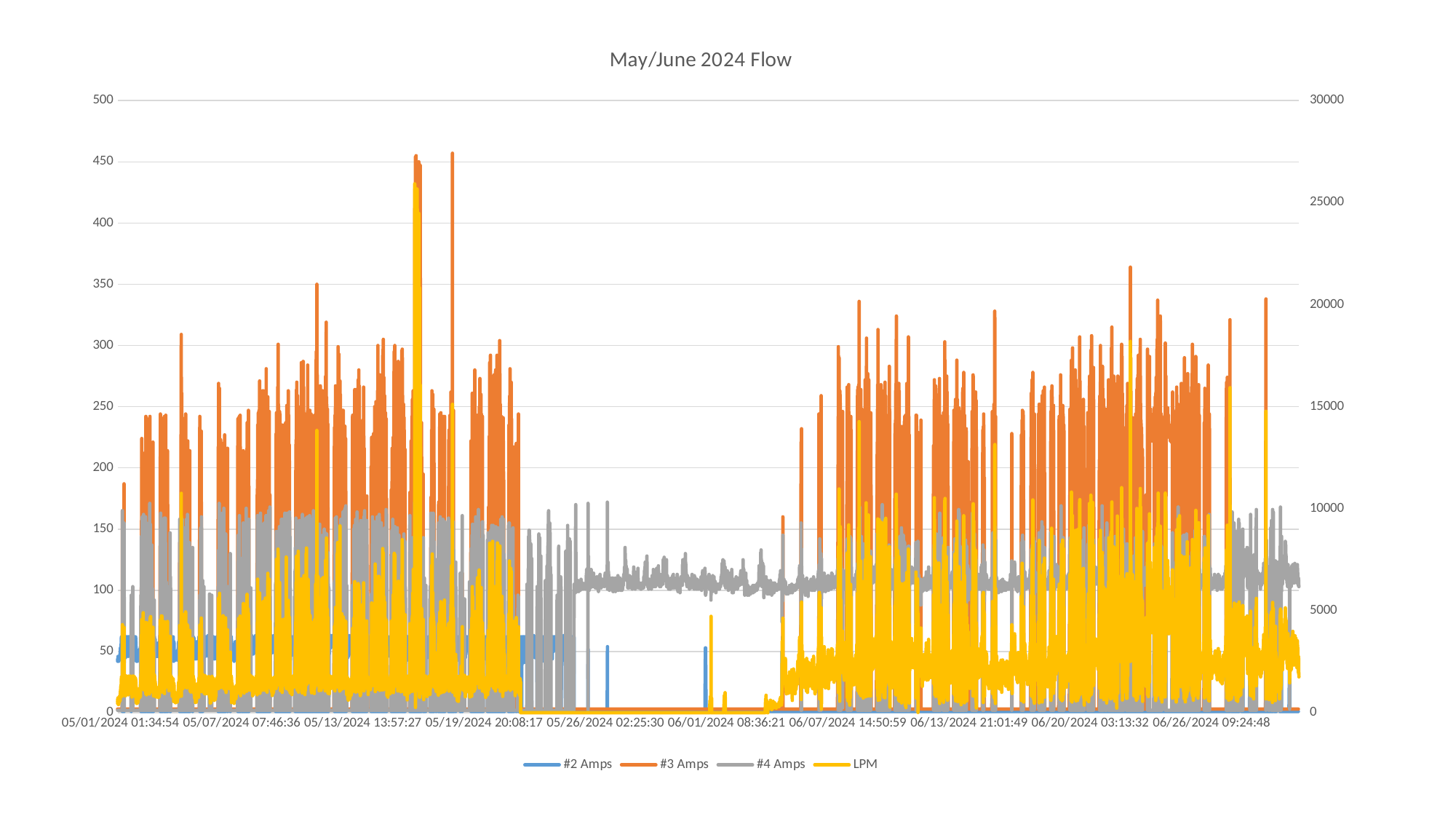
What is the title of the chart? May/June 2024 Flow How many date labels are shown along the x axis? 10 Between 05/26/2024 and 06/01/2024, is the #4 Amps series greater or less than 50 on the left axis? greater Is the highest peak of the #3 Amps series greater or less than 400 on the left axis? greater Between 05/26/2024 and 06/01/2024, which series is higher on the chart, #4 Amps or #3 Amps? #4 Amps What kind of chart is shown on the slide? line chart Is the highest peak of the #2 Amps series greater or less than 100 on the left axis? less How many series does the legend list? 4 What colour is the LPM series drawn in? yellow